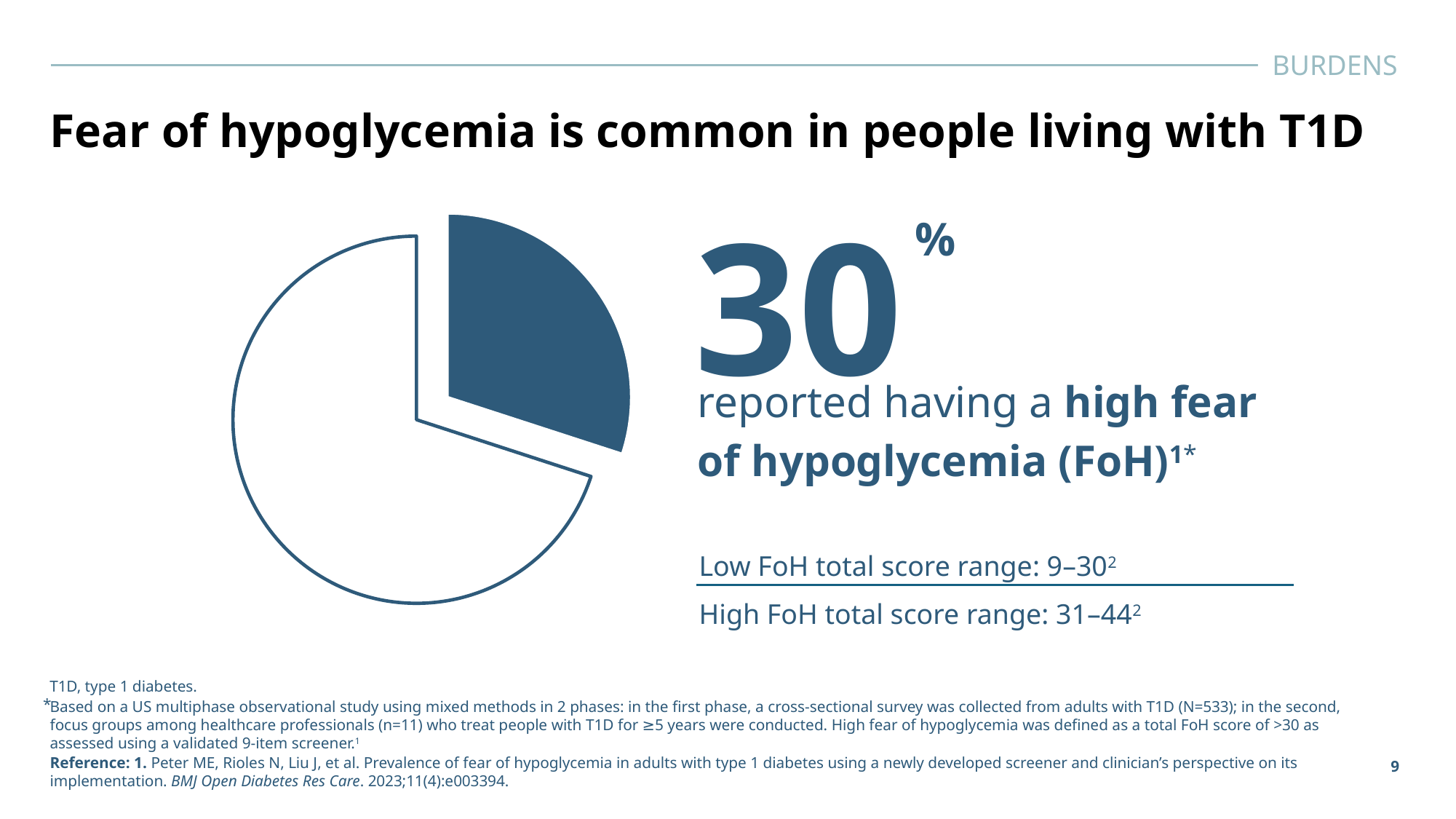
What share of the pie does the filled (exploded) slice represent? 30% What does the filled slice of the pie chart represent? people who reported having a high fear of hypoglycemia (FoH) What colour is the exploded slice of the pie chart? dark blue How many slices does the pie chart have? 2 Which slice of the pie is larger: the filled slice or the unfilled slice? the unfilled slice Which slice of the pie is the smallest? the filled slice (30%) What percentage of people reported having a high fear of hypoglycemia, according to the pie chart? 30% What kind of chart is shown on the slide? pie chart